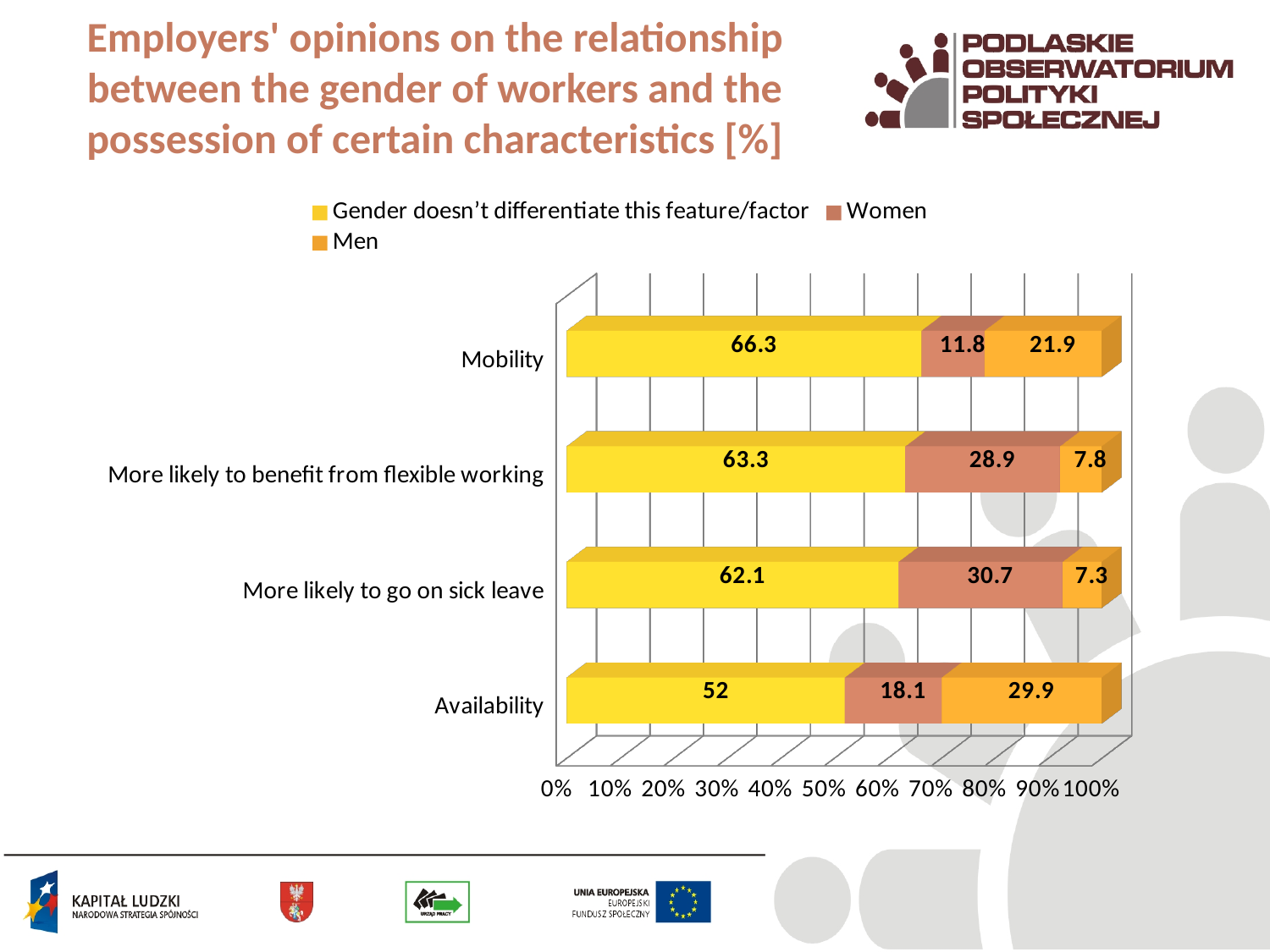
What is the value for Women for 'More likely to go on sick leave'? 30.7 Which is larger for 'Availability': the Women value or the Men value? Men What is the difference between the Women values for 'More likely to go on sick leave' and 'Mobility'? 18.9 How many categories are plotted on the chart? 4 What is the total of the stacked bar for 'More likely to benefit from flexible working'? 100 Which legend entry is shown in yellow? Gender doesn't differentiate this feature/factor What kind of chart is shown on the slide? Stacked bar chart What is the value for Men for 'Availability'? 29.9 What is the value for 'Gender doesn't differentiate this feature/factor' for 'Mobility'? 66.3 Which category has the highest value for 'Gender doesn't differentiate this feature/factor'? Mobility Which category has the lowest value for Men? More likely to go on sick leave How many series does the legend list? 3